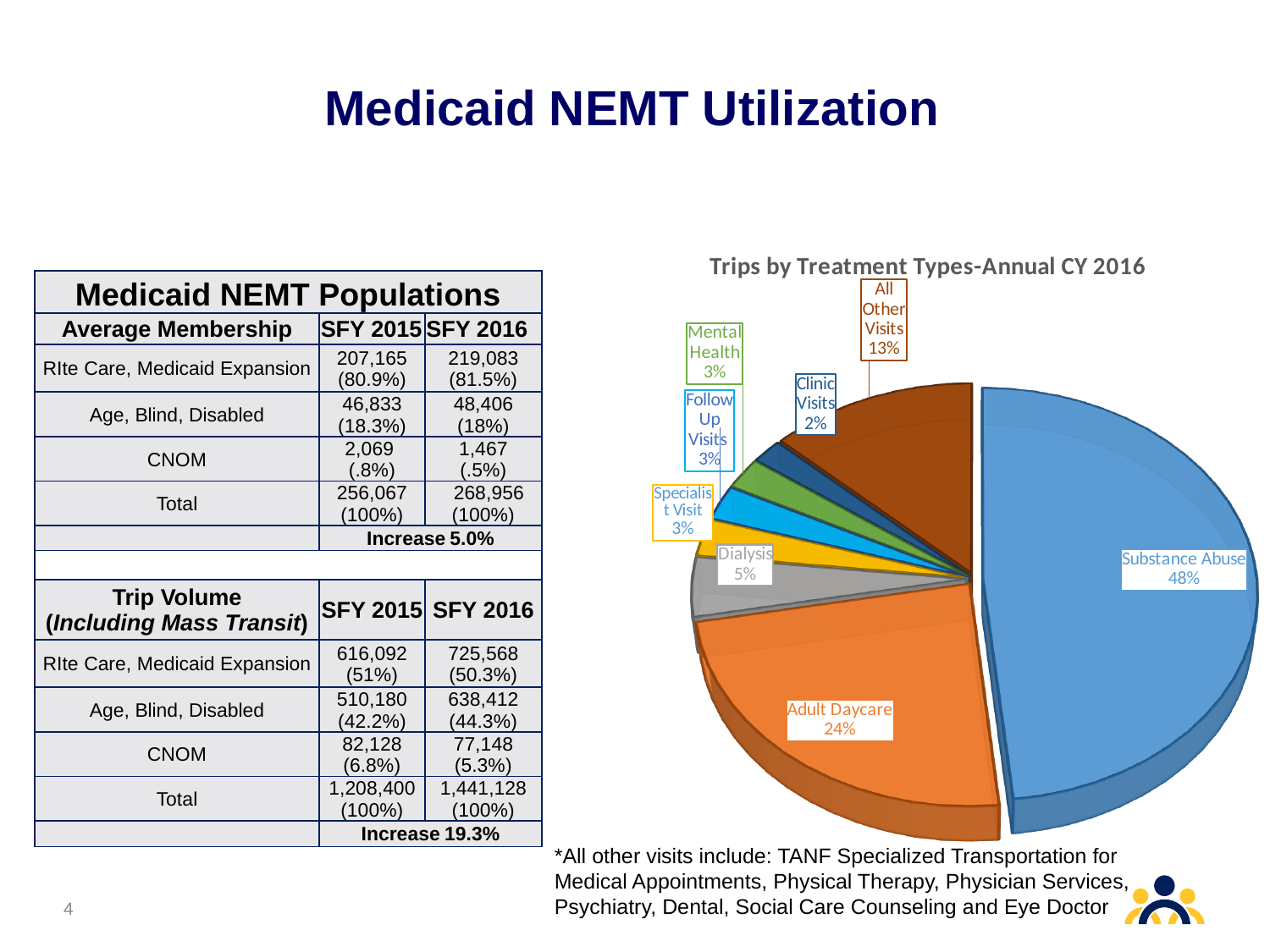
Which has a larger share of trips in the pie chart, Dialysis or Mental Health? Dialysis What is the title of the chart on the slide? Trips by Treatment Types-Annual CY 2016 Which treatment type has the largest share of trips in the pie chart? Substance Abuse What kind of chart is shown on the slide? Pie chart Which treatment type has the smallest share of trips in the pie chart? Clinic Visits What share of trips is for Substance Abuse in the pie chart? 48% What is the difference in percentage points between Substance Abuse and Adult Daycare in the pie chart? 24 percentage points What percentage of trips is labelled All Other Visits in the pie chart? 13% What percentage of trips is for Clinic Visits in the pie chart? 2% What percentage of trips is for Dialysis in the pie chart? 5% How many slices does the pie chart have? 8 What share of trips is for Adult Daycare in the pie chart? 24%